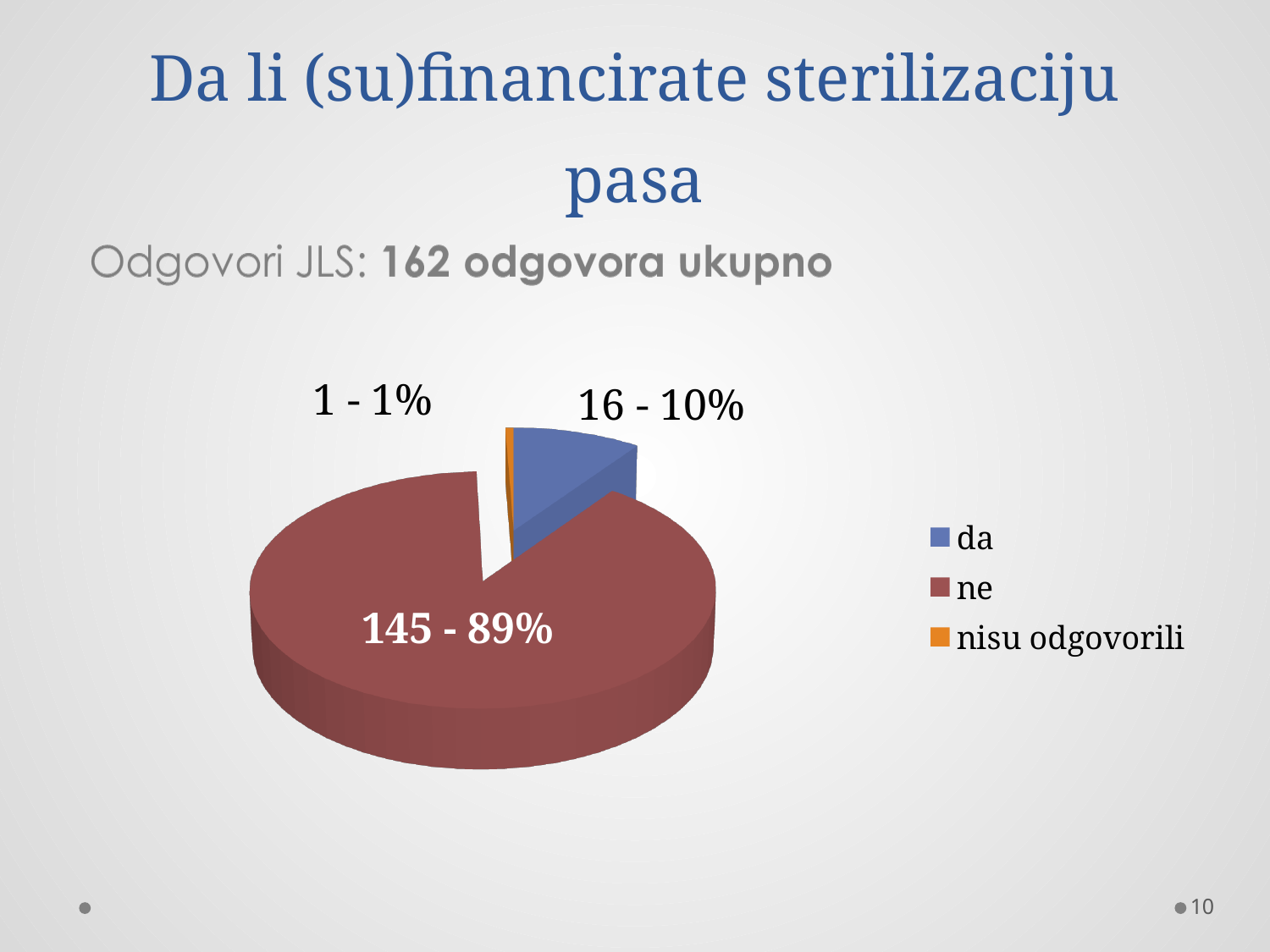
What is the difference in count between the "ne" and "da" slices? 129 Which category has the smallest slice? nisu odgovorili What is the count shown for the "ne" slice? 145 What is the count shown for the "nisu odgovorili" slice? 1 What percentage is shown for the "da" slice? 10% What kind of chart is shown on the slide? pie chart Which slice is larger, "da" or "nisu odgovorili"? da What colour is the "ne" slice? red What percentage is shown for the "nisu odgovorili" slice? 1% How many categories does the legend list? 3 What is the count shown for the "da" slice? 16 Which category has the largest slice? ne